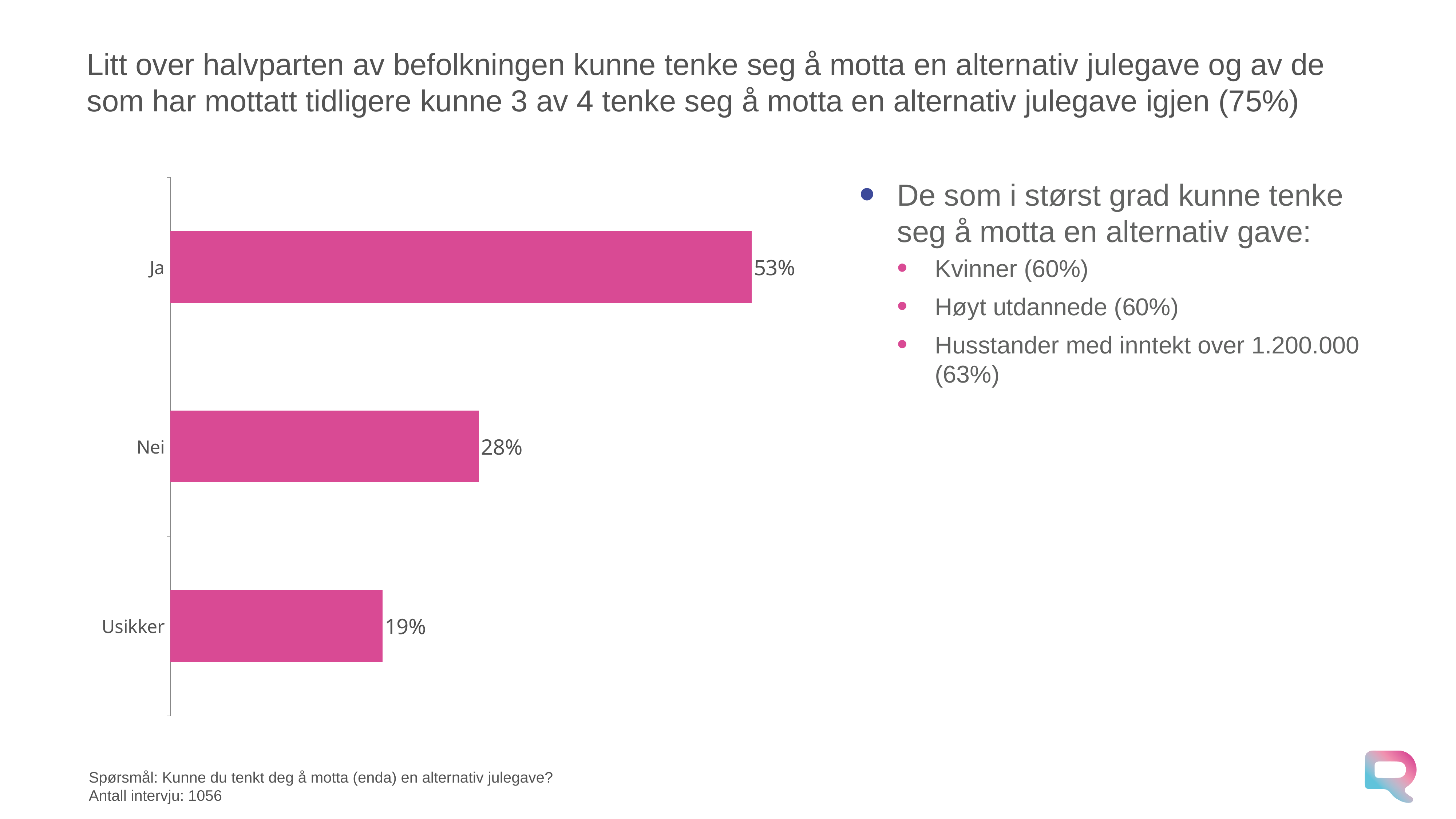
Which is larger, the value for Nei or the value for Usikker? Nei Which category has the highest value? Ja What colour are the bars in the chart? Pink What is the value for Ja? 53% What kind of chart is shown on the slide? Bar chart Which category has the lowest value? Usikker What is the total of the three values shown in the chart? 100% How many categories are shown in the chart? 3 What is the difference between the values for Nei and Usikker? 9% What is the value for Usikker? 19% What is the value for Nei? 28% What is the difference between the values for Ja and Nei? 25%